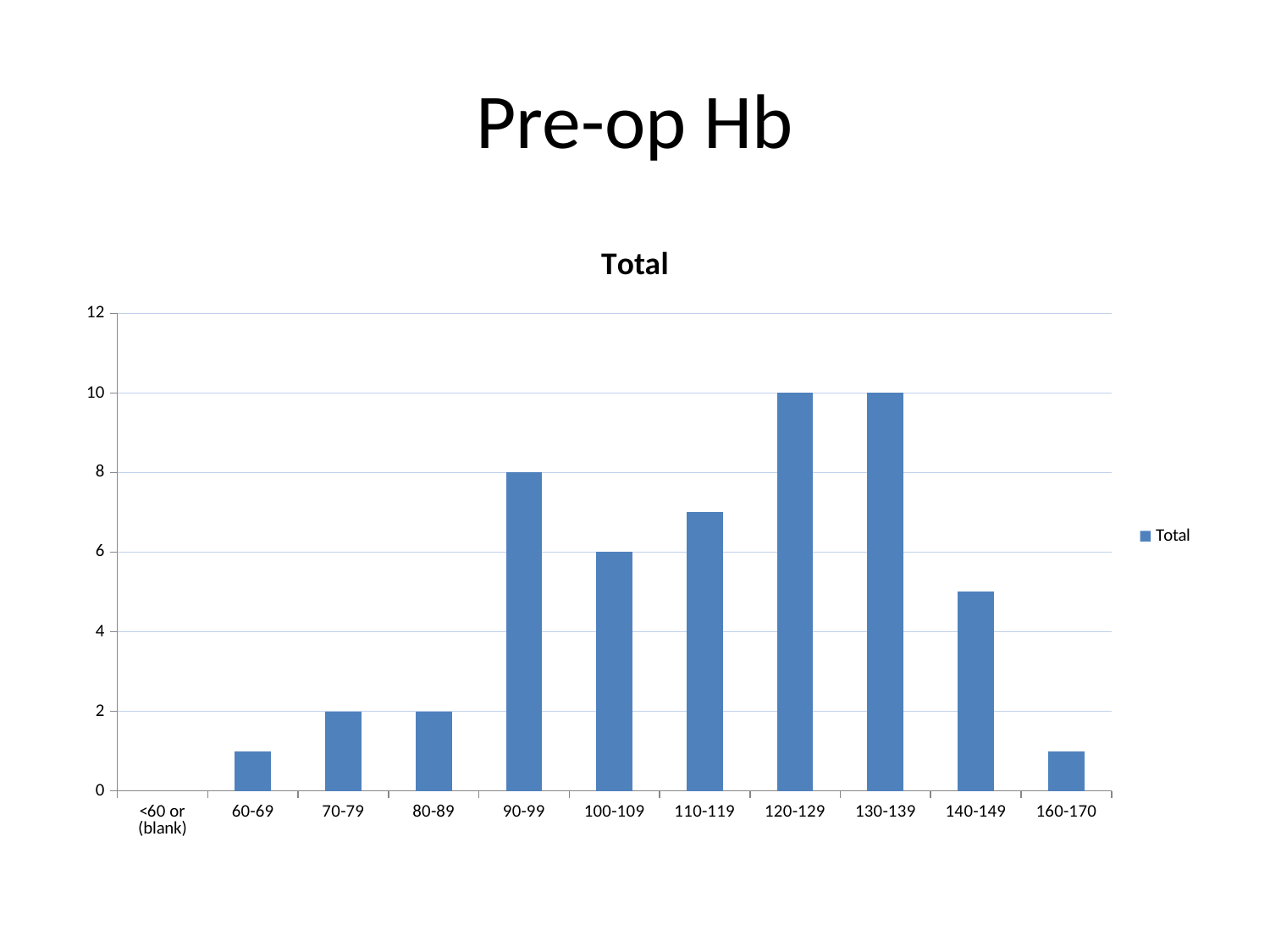
What is the value for the 90-99 category? 8 Is the value for 110-119 greater or less than 6? greater Is the value for 140-149 greater or less than 6? less What kind of chart is shown on the slide? bar chart Which is larger, the value for 90-99 or the value for 100-109? 90-99 What is the value for the 120-129 category? 10 How many categories are shown on the x axis? 11 What is the difference between the values for 90-99 and 100-109? 2 What is the value for the 100-109 category? 6 What is the value for the 70-79 category? 2 How many series does the legend list? 1